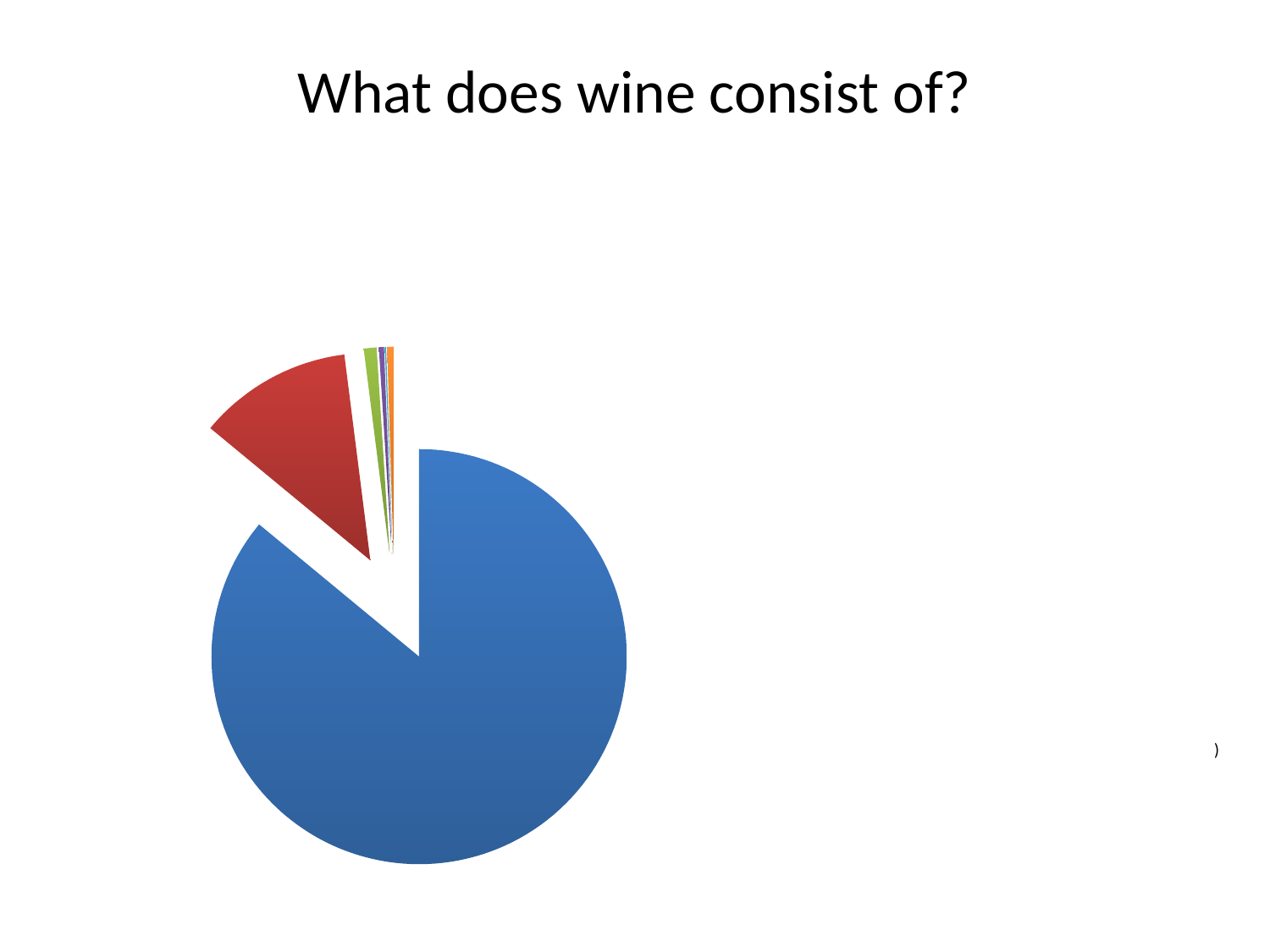
Which is larger in the pie chart, the red slice or the green slice? red What kind of chart is shown on the slide? pie chart Which is larger in the pie chart, the blue slice or the red slice? blue Which colour slice of the pie chart is the largest? blue What is the title of the slide containing the pie chart? What does wine consist of? Does the blue slice take up more or less than half of the pie chart? more